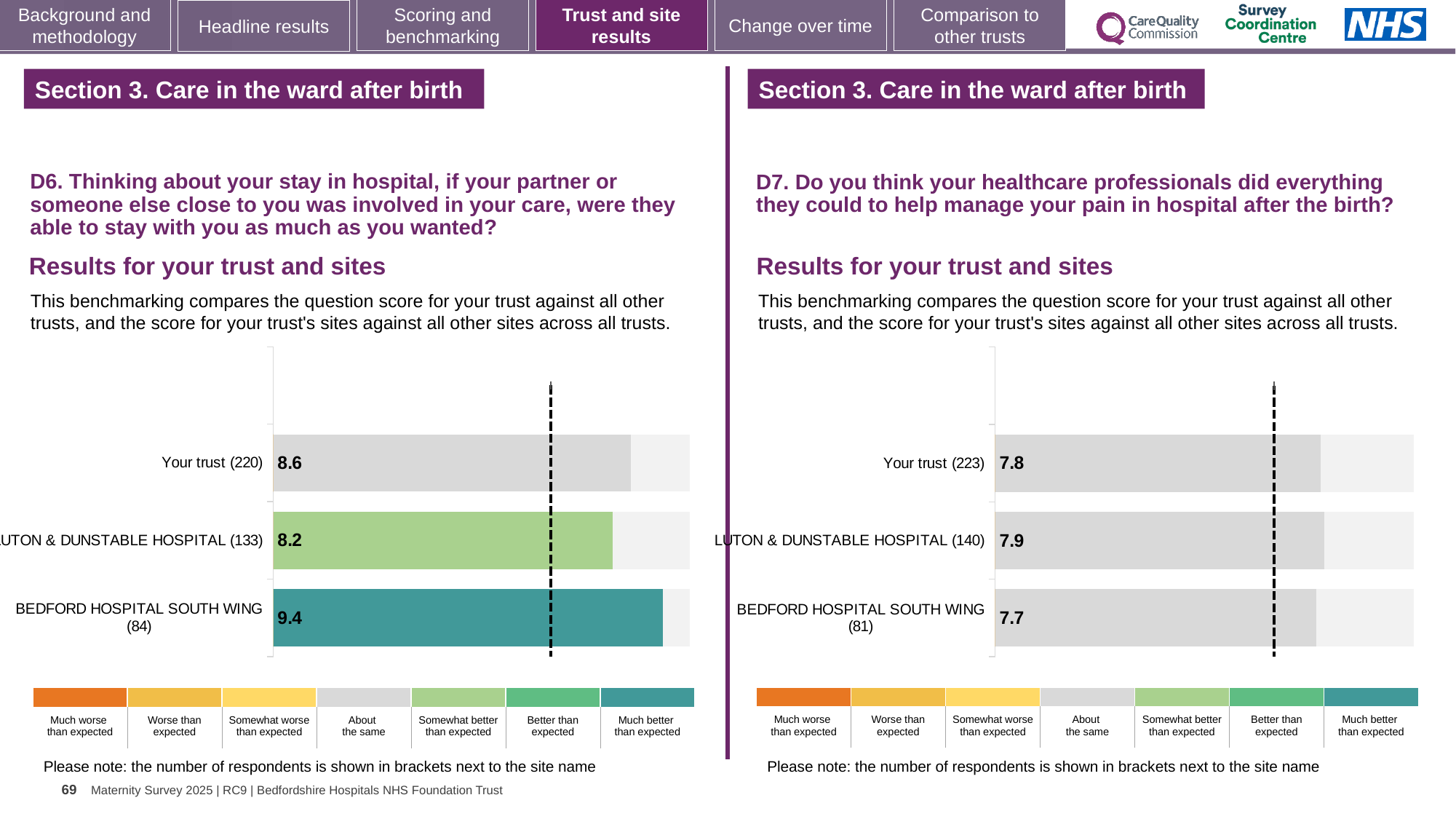
On the left chart (D6), what is the score for BEDFORD HOSPITAL SOUTH WING? 9.4 On the left chart (D6), which site or trust has the highest score? BEDFORD HOSPITAL SOUTH WING On the right chart (D7), what is the score for LUTON & DUNSTABLE HOSPITAL? 7.9 On the left chart (D6), how many bars are plotted? 3 On the left chart (D6), what is the difference between the scores for BEDFORD HOSPITAL SOUTH WING and LUTON & DUNSTABLE HOSPITAL? 1.2 On the left chart (D6), which site or trust has the lowest score? LUTON & DUNSTABLE HOSPITAL On the left chart (D6), how many respondents are shown in brackets for Your trust? 220 What kind of chart is shown on the right (D7)? Bar chart On the left chart (D6), which benchmark category does the colour of the BEDFORD HOSPITAL SOUTH WING bar correspond to? Much better than expected On the right chart (D7), what is the score for Your trust? 7.8 On the left chart (D6), what is the score for Your trust? 8.6 On the right chart (D7), what is the difference between the scores for LUTON & DUNSTABLE HOSPITAL and BEDFORD HOSPITAL SOUTH WING? 0.2